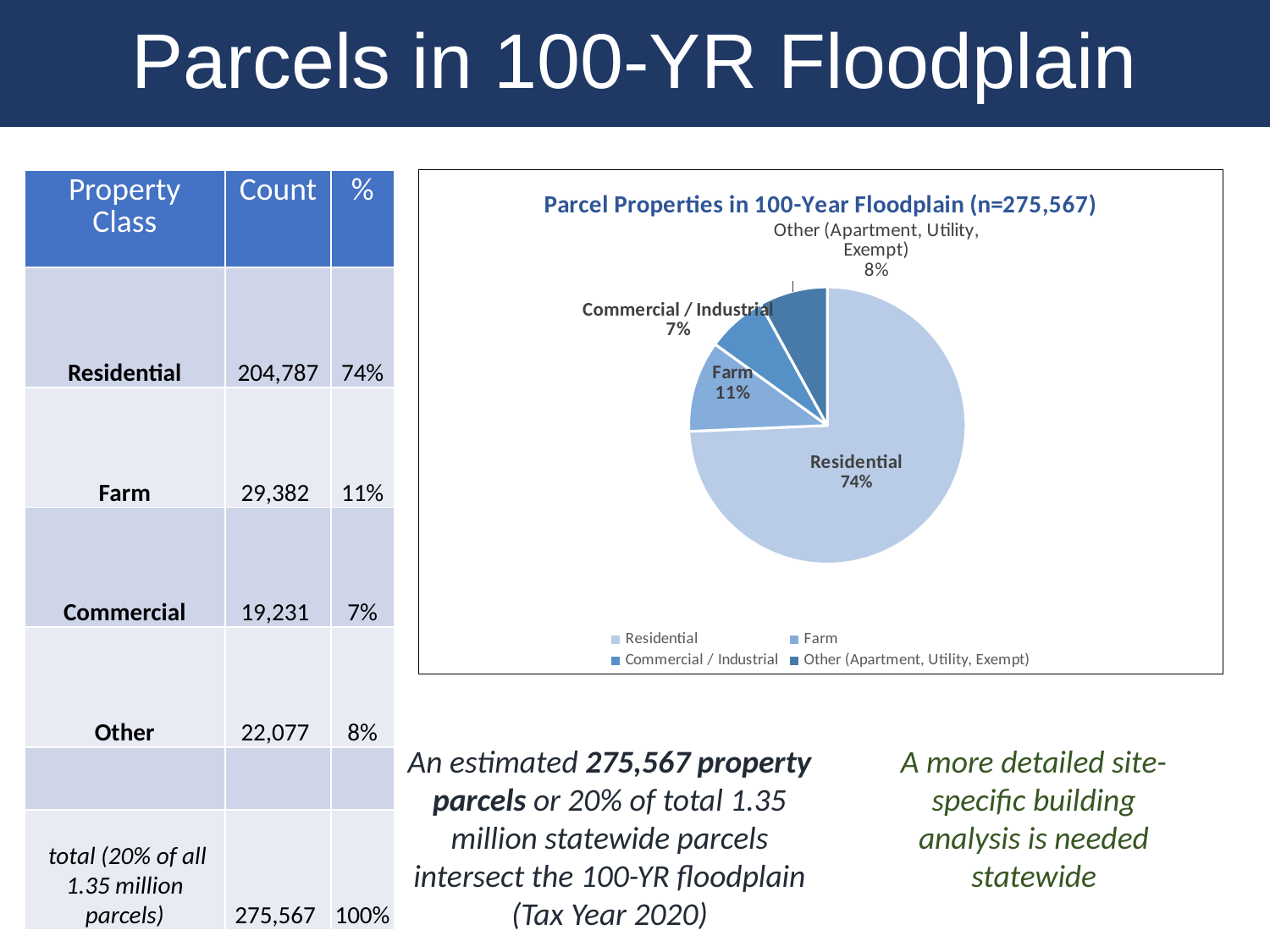
What share of the pie does Other (Apartment, Utility, Exempt) represent? 8% Which slice of the pie chart is the smallest? Commercial / Industrial What share of the pie does Commercial / Industrial represent? 7% What is the title of the pie chart? Parcel Properties in 100-Year Floodplain (n=275,567) What kind of chart is shown on the slide? pie chart What share of the pie does Residential represent? 74% How many slices does the pie chart have? 4 Which slice is larger, Farm or Other (Apartment, Utility, Exempt)? Farm What is the difference in percentage points between the Residential and Farm slices? 63 Which slice of the pie chart is the largest? Residential How many entries does the legend of the pie chart list? 4